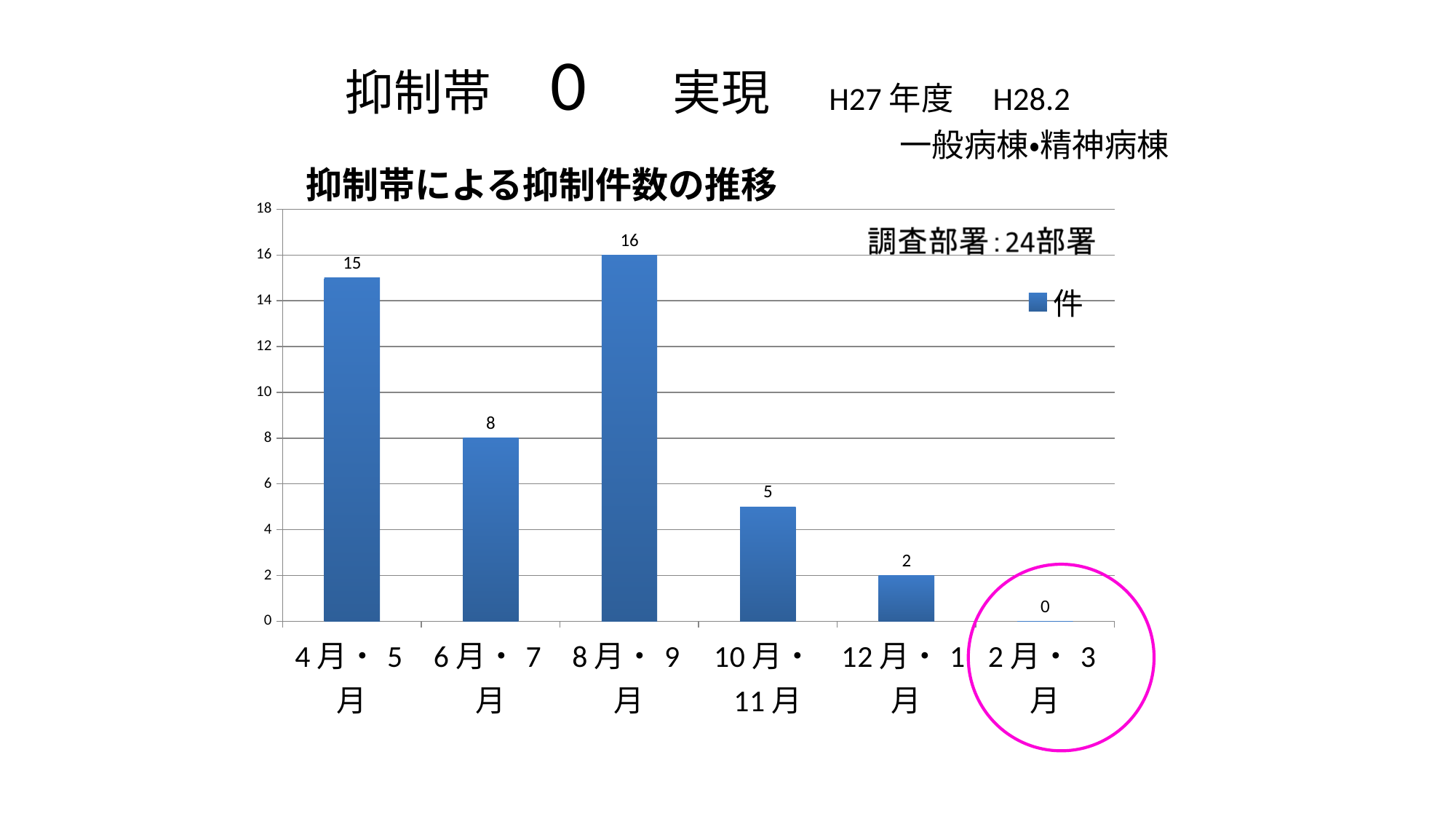
What is the value for 8月・9月? 16 What is the value for 4月・5月? 15 Which category has the highest value? 8月・9月 What kind of chart is shown? bar chart What is the title of the chart? 抑制帯による抑制件数の推移 How many categories are shown on the x axis? 6 What is the difference between the values for 8月・9月 and 6月・7月? 8 What is the value for 2月・3月? 0 Do the values rise or fall from 8月・9月 to 2月・3月? fall How many series does the legend list? 1 Which category has the lowest value? 2月・3月 Which is larger, the value for 10月・11月 or the value for 12月・1月? 10月・11月